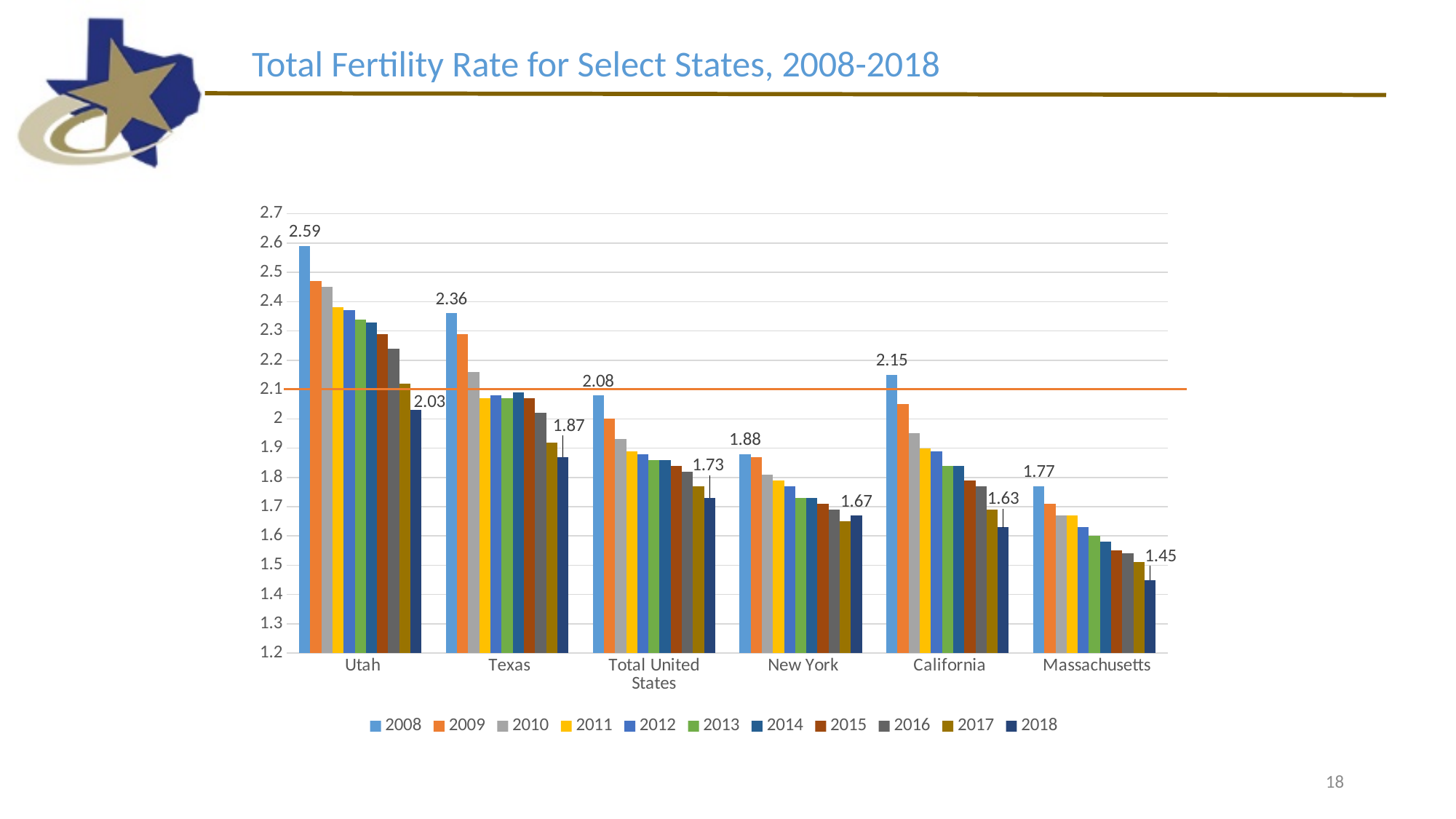
What was Texas's total fertility rate in 2018? 1.87 Within each category, do the values rise or fall from 2008 to 2018? fall Is the 2018 value for Total United States greater or less than 1.8? less Which state had the highest total fertility rate in 2008? Utah Which category had the lowest total fertility rate in 2018? Massachusetts What was Utah's total fertility rate in 2008? 2.59 Which was higher in 2018: the total fertility rate for New York or for California? New York What was Massachusetts's total fertility rate in 2018? 1.45 By how much did Texas's total fertility rate fall from 2008 to 2018? 0.49 How many states or categories are shown on the x axis? 6 What was California's total fertility rate in 2008? 2.15 How many series (years) does the legend list? 11